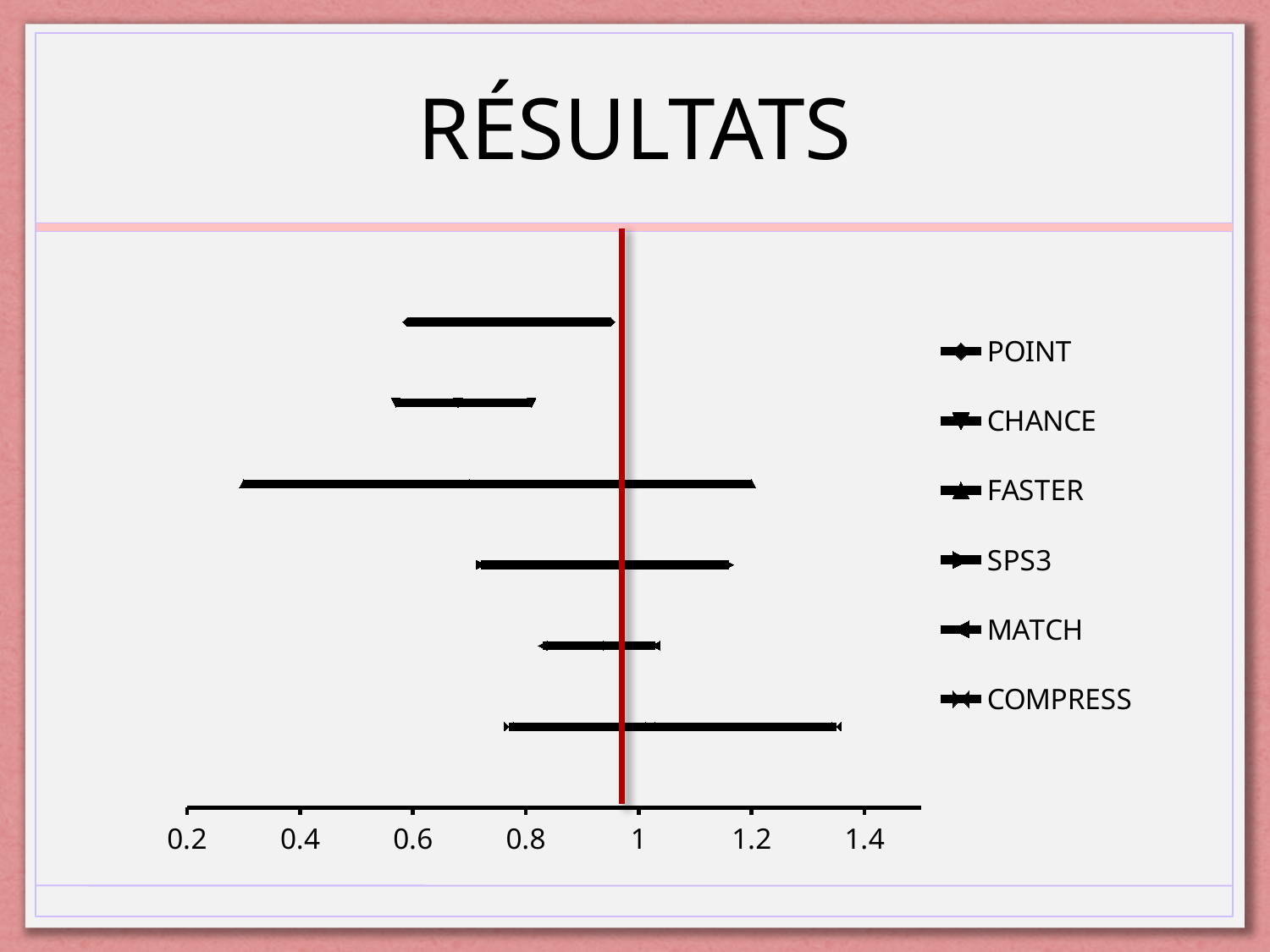
Which series is listed first in the chart legend? POINT How many horizontal lines (intervals) are plotted on the chart? 6 Is the right end of the topmost horizontal line greater or less than 1? less Which horizontal line on the chart spans the widest range of values? the third line from the top Is the left end of the third horizontal line from the top greater or less than 0.4? less How many series does the chart legend list? 6 What is the lowest value labelled on the chart's x axis? 0.2 What is the highest value labelled on the chart's x axis? 1.4 Is the right end of the bottom horizontal line greater or less than 1.2? greater What is the title of the slide containing the chart? RÉSULTATS